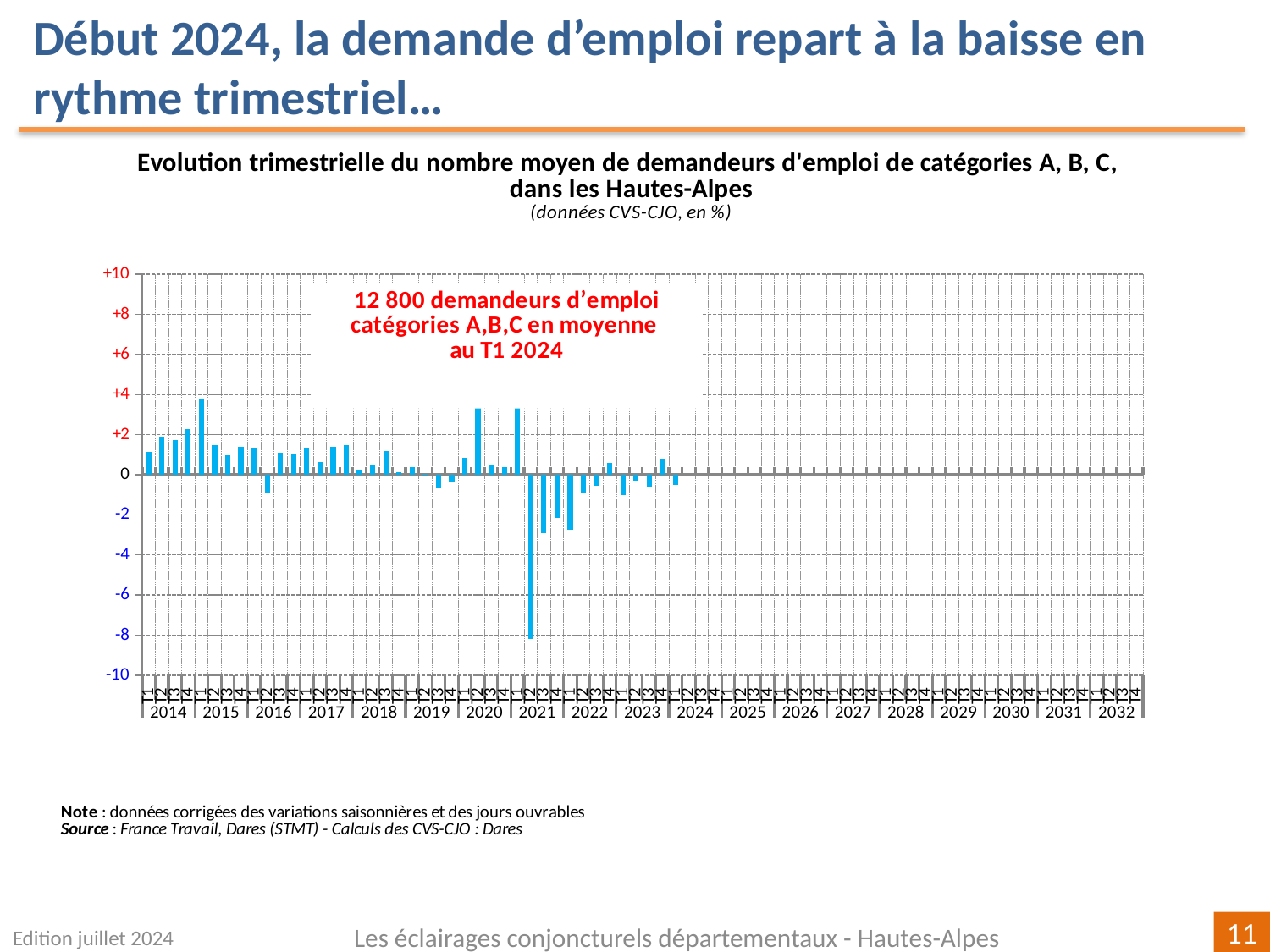
Which quarter has the lowest value on the chart? T2 2021 According to the annotation on the chart, how many demandeurs d'emploi of catégories A, B, C were there on average in T1 2024? 12 800 Is the value for T2 2021 greater or less than -6? less Is the value for T1 2022 greater or less than -2? less Is the value for T2 2020 greater or less than +2? greater What kind of chart is shown on the slide? bar chart How many year labels appear along the x axis of the chart? 19 Which is lower, the value for T2 2021 or the value for T1 2022? T2 2021 Which is larger, the value for T1 2015 or the value for T2 2016? T1 2015